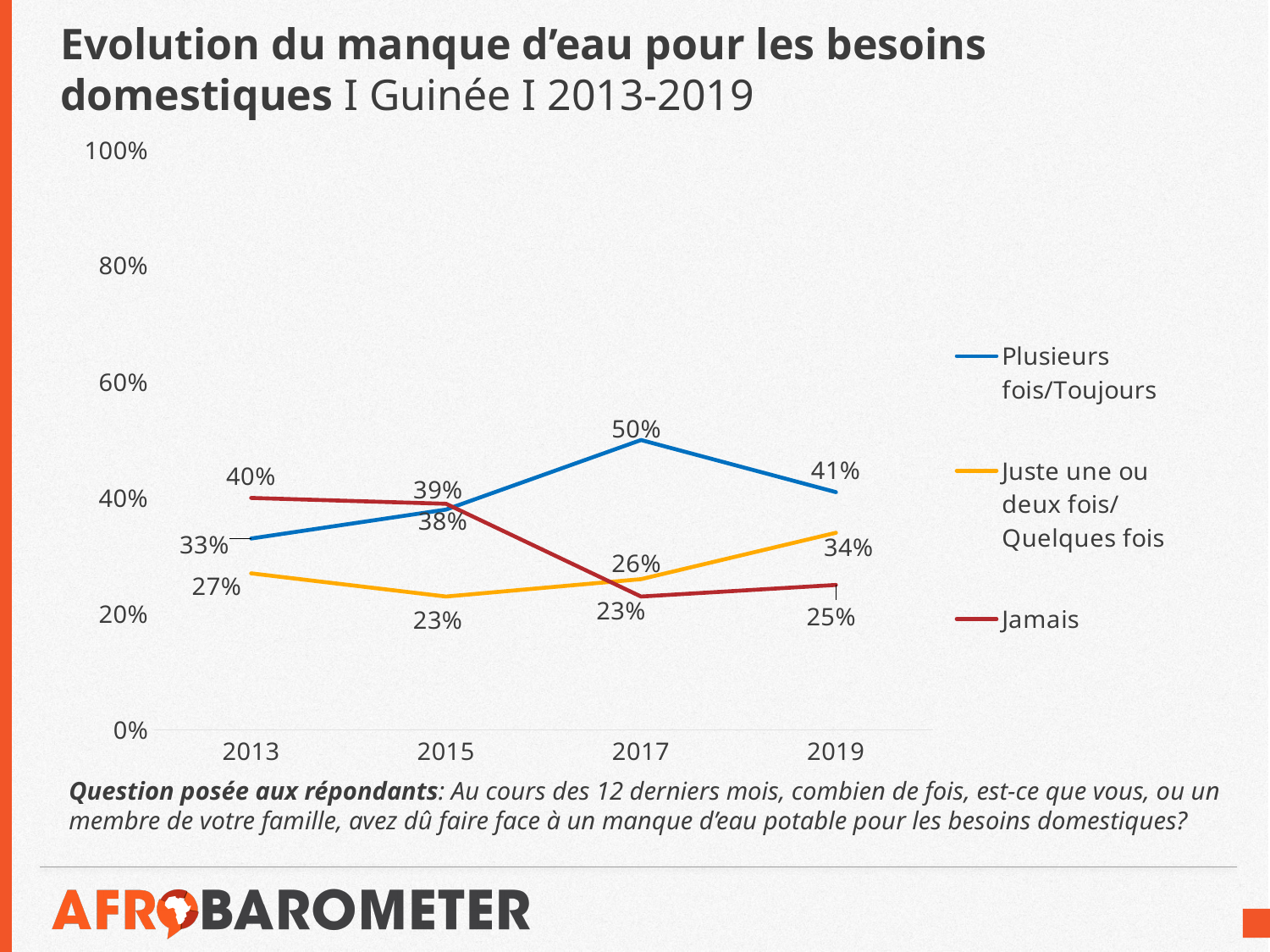
How many series does the legend list? 3 Does the value for Jamais rise or fall from 2013 to 2017? fall Which country does the chart title refer to? Guinée What is the value for Jamais in 2013? 40% What is the value for Juste une ou deux fois/Quelques fois in 2019? 34% What is the difference between the Plusieurs fois/Toujours value in 2017 and in 2013? 17 percentage points How many years are plotted on the x axis? 4 In which year is the value for Jamais lowest? 2017 What is the value for Plusieurs fois/Toujours in 2017? 50% What type of chart is shown on the slide? line chart Which is larger in 2019: Plusieurs fois/Toujours or Jamais? Plusieurs fois/Toujours In which year does Plusieurs fois/Toujours reach its highest value? 2017